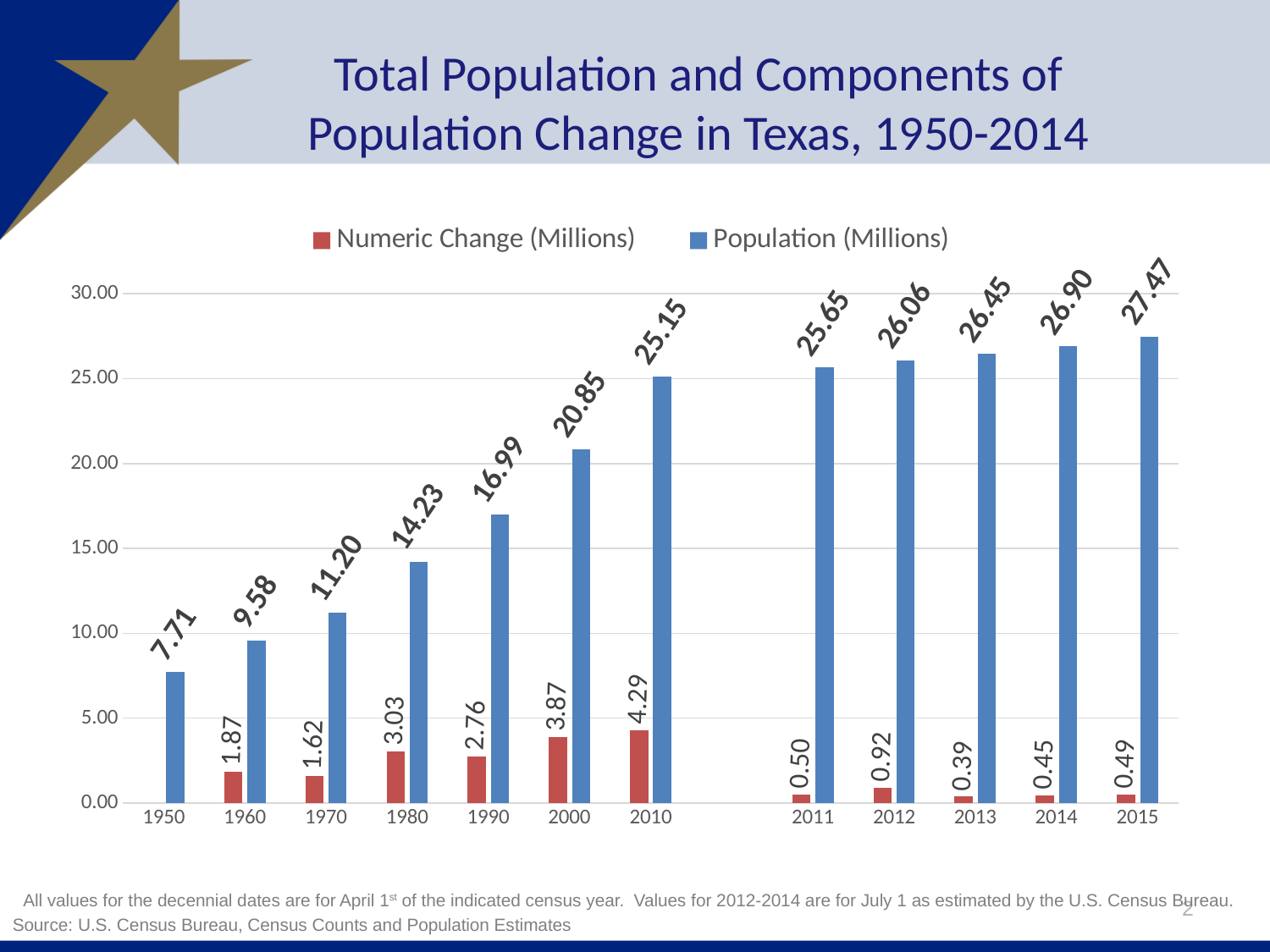
How many series does the legend list? 2 Which year has the lowest Numeric Change (Millions) value? 2013 What is the Numeric Change (Millions) value for 1980? 3.03 What is the difference between the Population (Millions) values for 2015 and 2014? 0.57 Which year has the highest Numeric Change (Millions) value? 2010 Which year has the larger Numeric Change (Millions) value, 1990 or 2000? 2000 What is the Population (Millions) value for 2010? 25.15 How many years are shown on the x axis? 12 Does the Population (Millions) series rise or fall from 1950 to 2015? Rise What kind of chart is shown on the slide? Bar chart Which year has the highest Population (Millions) value? 2015 What is the Population (Millions) value for 1950? 7.71